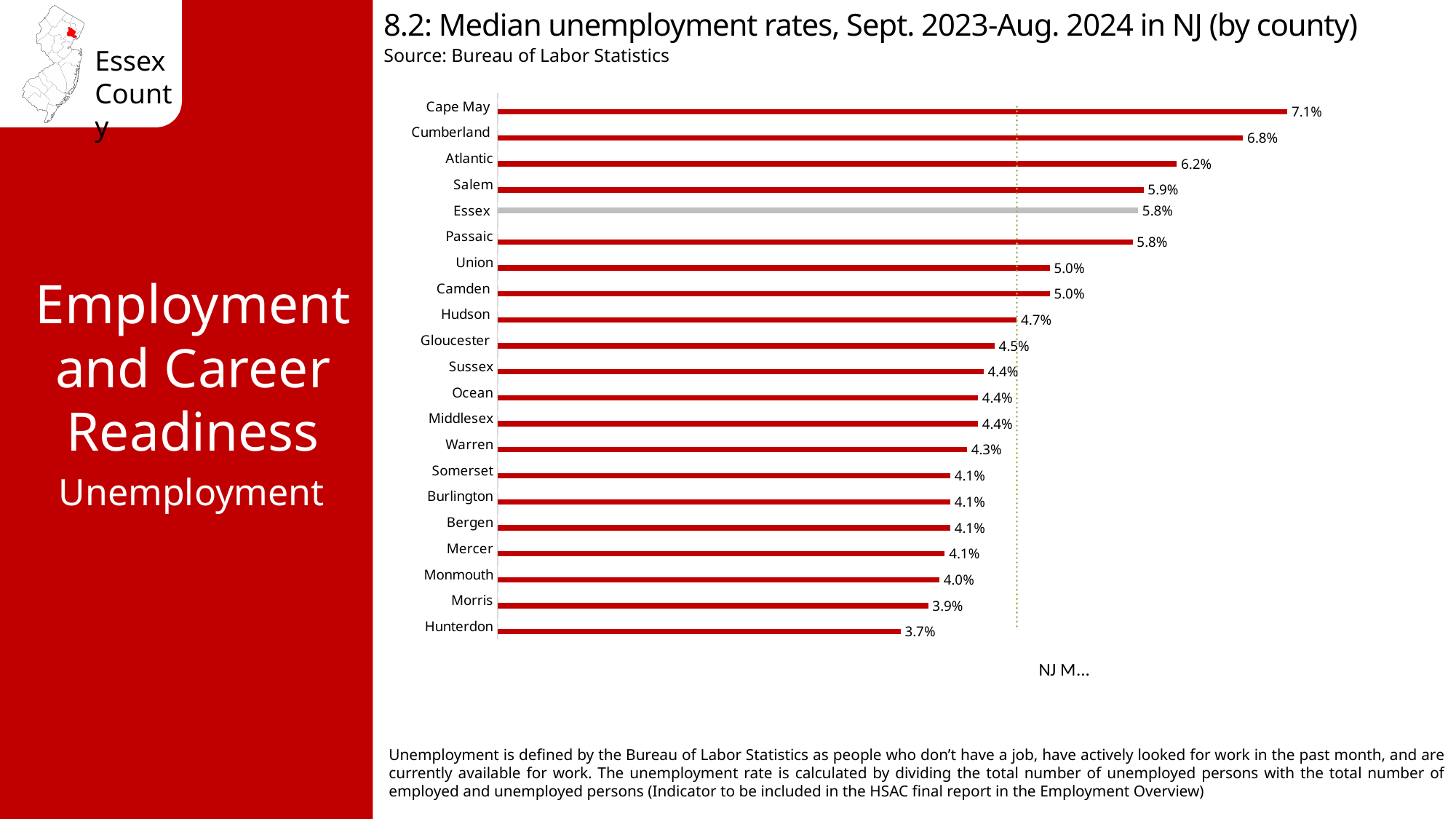
Which county has the highest median unemployment rate? Cape May Which county has the lowest median unemployment rate? Hunterdon What is the median unemployment rate for Essex County? 5.8% Which county has a higher median unemployment rate, Gloucester or Morris? Gloucester How many counties are shown in the chart? 21 What is the difference between the median unemployment rates of Cape May and Hunterdon? 3.4% What is the difference between the median unemployment rates of Cumberland and Atlantic? 0.6% Which county has a higher median unemployment rate, Salem or Union? Salem Which county's bar is shown in grey instead of red? Essex What is the median unemployment rate for Hudson? 4.7% What kind of chart is used to show the median unemployment rates? Bar chart What is the median unemployment rate for Cape May? 7.1%